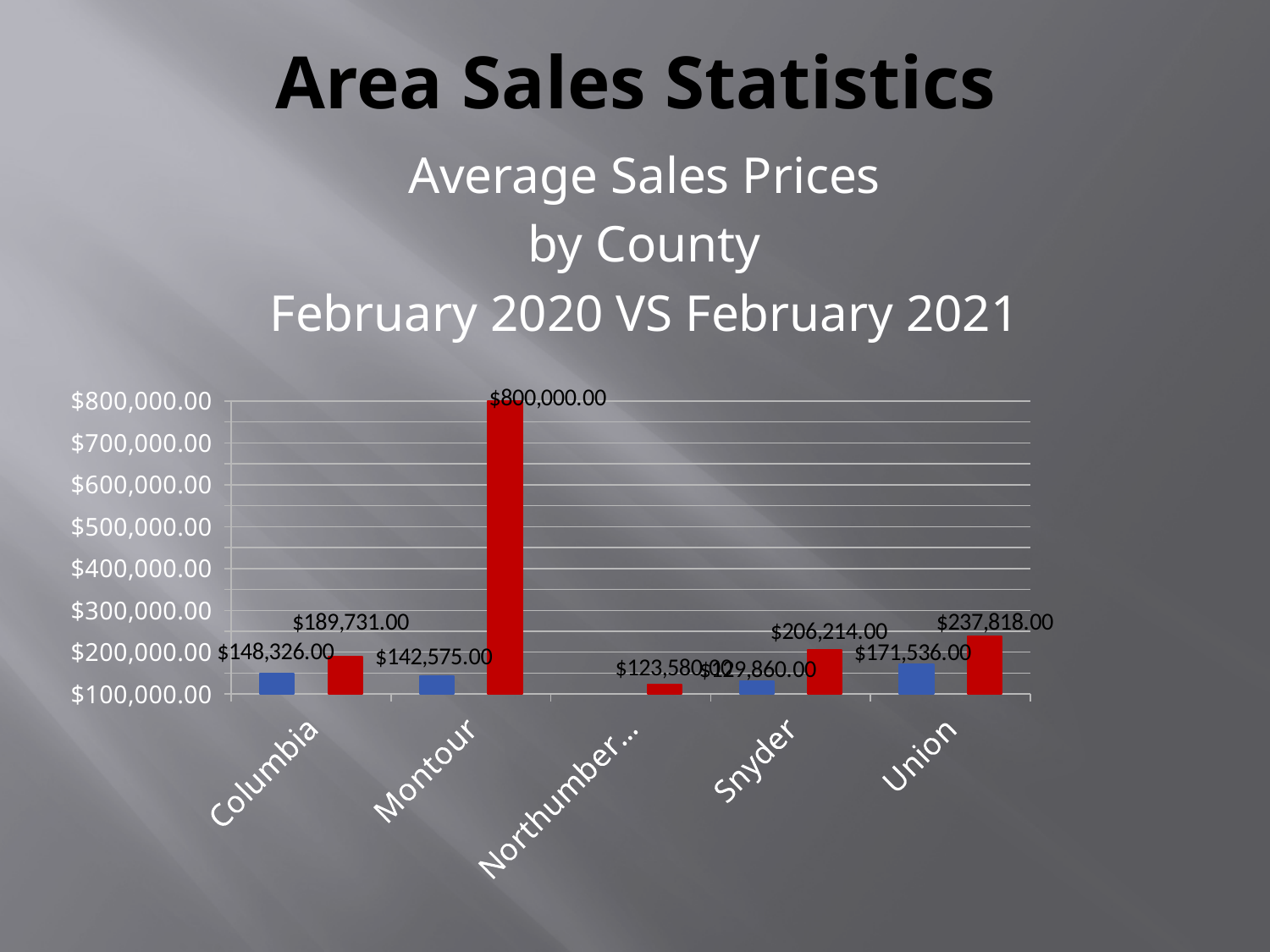
What is the value of the red bar for Snyder? $206,214.00 What is the value of the red bar for Union? $237,818.00 Is the value of the red bar for Montour greater or less than $700,000.00? greater Which county has the highest bar in the chart? Montour What is the difference between the red bar and the blue bar for Union? $66,282.00 What is the value of the blue bar for Union? $171,536.00 For Columbia, which is larger, the red bar or the blue bar? the red bar How many counties are shown on the x axis of the chart? 5 What is the value of the blue bar for Columbia? $148,326.00 What is the title of the chart? Average Sales Prices by County February 2020 VS February 2021 What is the value of the red bar for Montour? $800,000.00 What kind of chart is shown on the slide? bar chart